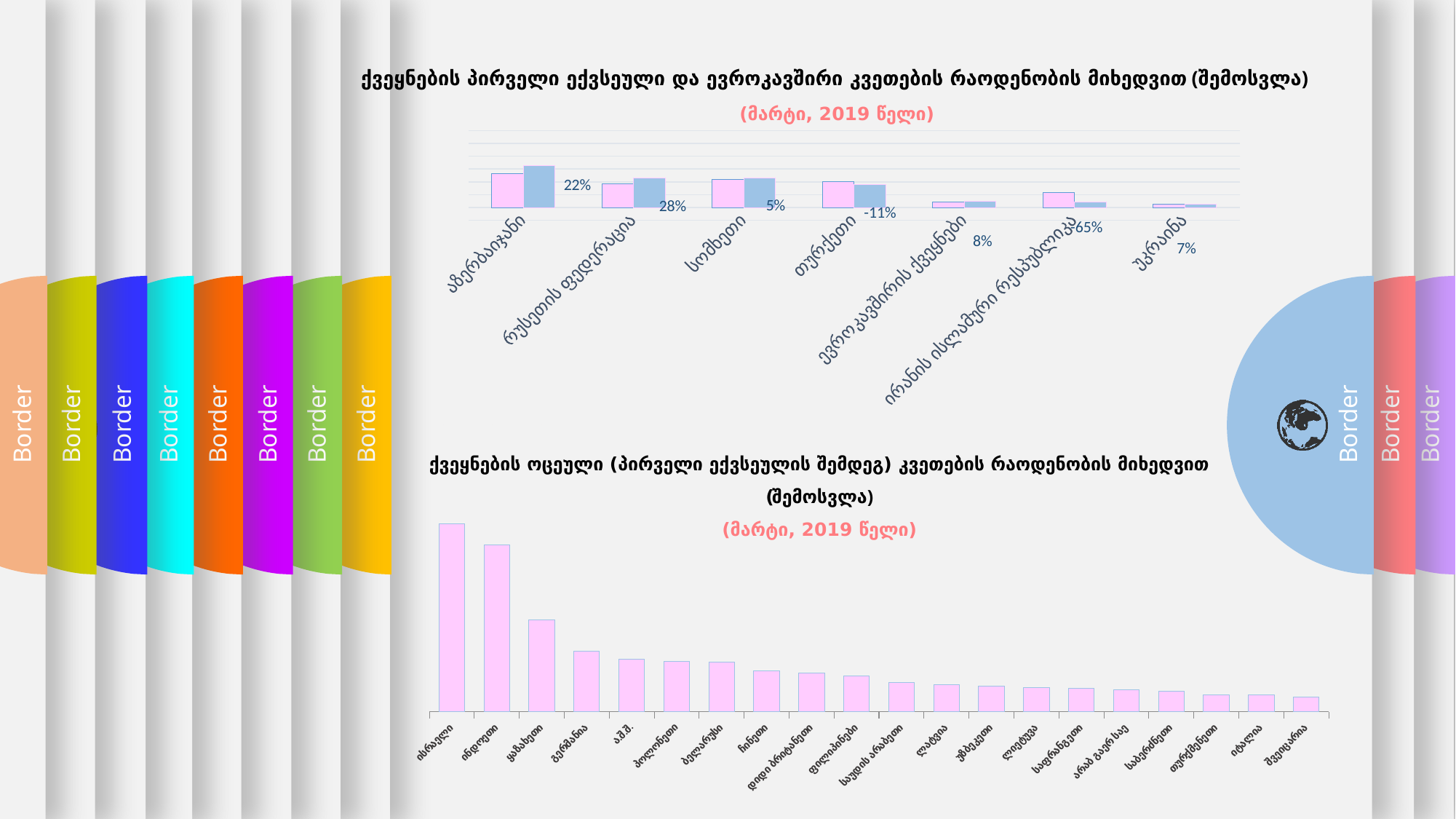
In the top chart, what percentage label is printed next to the bars for ირანის ისლამური რესპუბლიკა? -65% In the top chart, what percentage label is printed next to the bars for თურქეთი? -11% In the bottom chart, which bar is taller: ყაზახეთი or გერმანია? ყაზახეთი In the bottom chart, which country has the highest bar? ისრაელი In the bottom chart, do the bar heights rise or fall from left to right along the x axis? fall In the top chart, what percentage label is printed next to the bars for რუსეთის ფედერაცია? 28% What kind of chart is the bottom chart on the slide? bar chart In the top chart, how many countries/categories are shown on the x axis? 7 In the bottom chart, how many countries are shown on the x axis? 20 What kind of chart is the top chart on the slide? bar chart In the top chart, which category has the tallest bars? აზერბაიჯანი In the top chart, which category has the shortest bars? უკრაინა